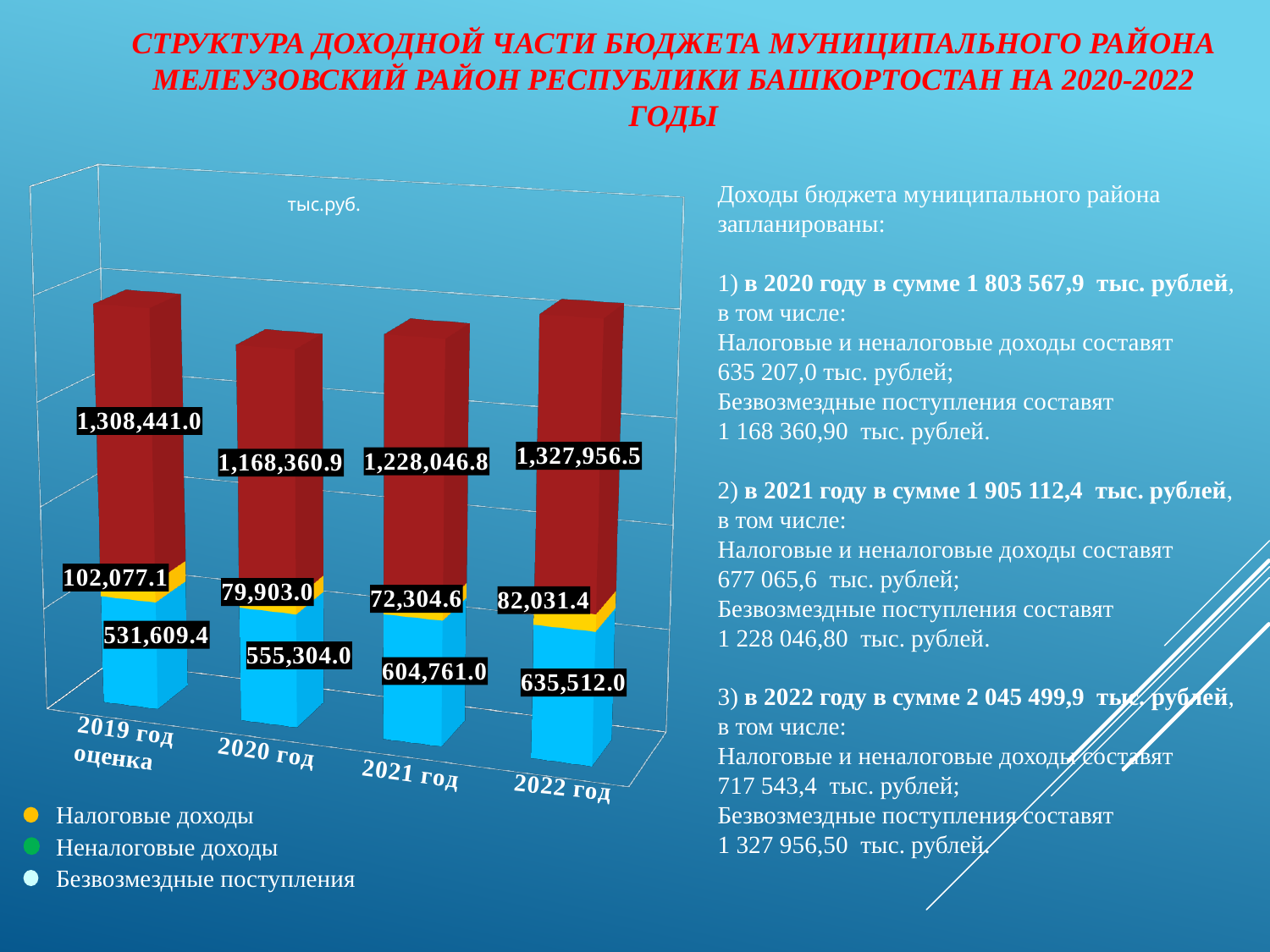
What is the value of the bottom (blue) segment of the bar for 2021 год? 604,761.0 What unit label is shown at the top of the chart? тыс.руб. Which year has the highest value for the top (red) segment? 2022 год What is the total of the stacked bar for 2020 год? 1,803,567.9 What type of chart is shown on the slide? Stacked bar chart Do the bottom (blue) segment values rise or fall from 2019 год оценка to 2022 год? Rise How many years (categories) are shown on the x axis of the chart? 4 What is the value of the middle (yellow) segment of the bar for 2020 год? 79,903.0 What is the value of the top (red) segment of the bar for 2019 год оценка? 1,308,441.0 Which year has the lowest value for the middle (yellow) segment? 2021 год What is the difference between the bottom (blue) segment values for 2022 год and 2019 год оценка? 103,902.6 Which is larger: the top (red) segment for 2020 год or for 2021 год? 2021 год